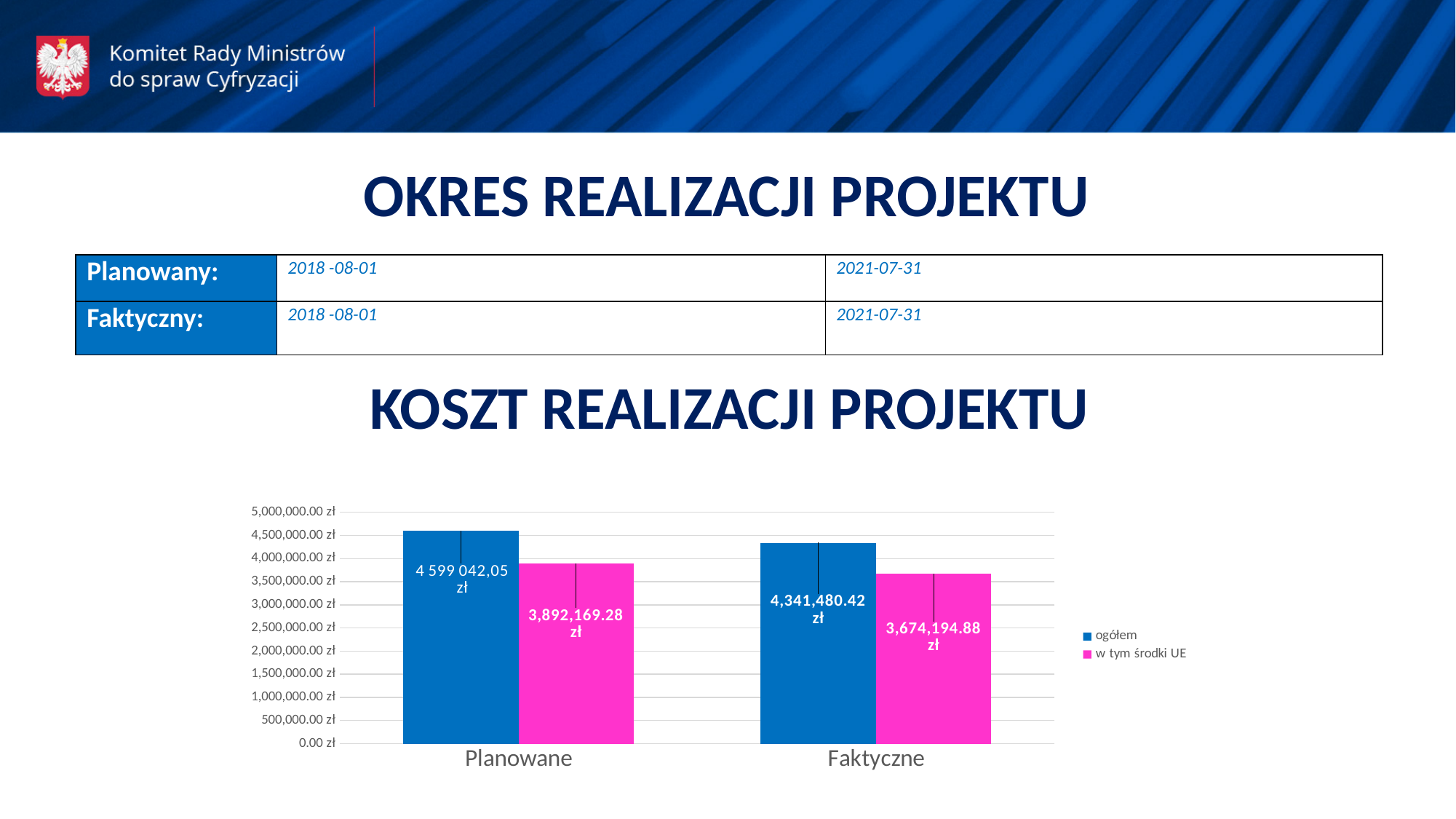
What is the value of ogółem for Planowane? 4 599 042,05 zł What is the difference between ogółem and w tym środki UE for Faktyczne? 667,285.54 zł What is the value of w tym środki UE for Planowane? 3,892,169.28 zł What is the difference between the w tym środki UE values for Planowane and Faktyczne? 217,974.40 zł Which bar is the lowest in the chart? w tym środki UE for Faktyczne Which colour represents the series w tym środki UE in the legend? pink What is the value of w tym środki UE for Faktyczne? 3,674,194.88 zł What is the value of ogółem for Faktyczne? 4,341,480.42 zł What type of chart is shown under the heading KOSZT REALIZACJI PROJEKTU? bar chart Which category has the higher ogółem value, Planowane or Faktyczne? Planowane How many categories are shown on the x axis? 2 How many series does the legend list? 2